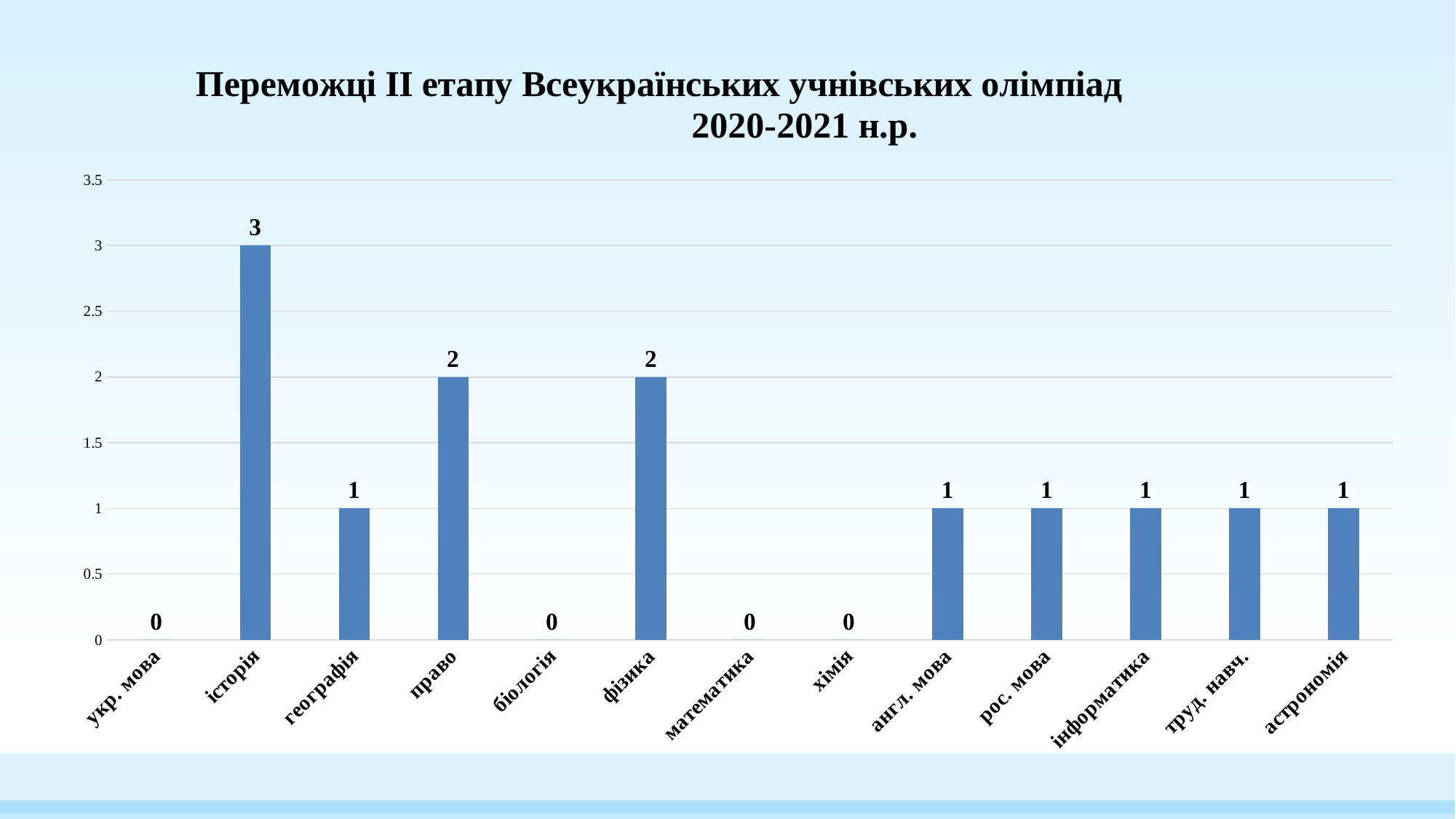
Is the value for історія greater or less than 2.5? greater What is the value for право? 2 How many categories have a value of 0? 4 What is the difference between the values for історія and фізика? 1 Which is larger, the value for право or the value for інформатика? право Which category has the highest value? історія What is the value for математика? 0 What is the value for географія? 1 What is the title of the chart? Переможці ІІ етапу Всеукраїнських учнівських олімпіад 2020-2021 н.р. How many categories are shown on the x axis? 13 What is the value for історія? 3 What kind of chart is shown on the slide? bar chart